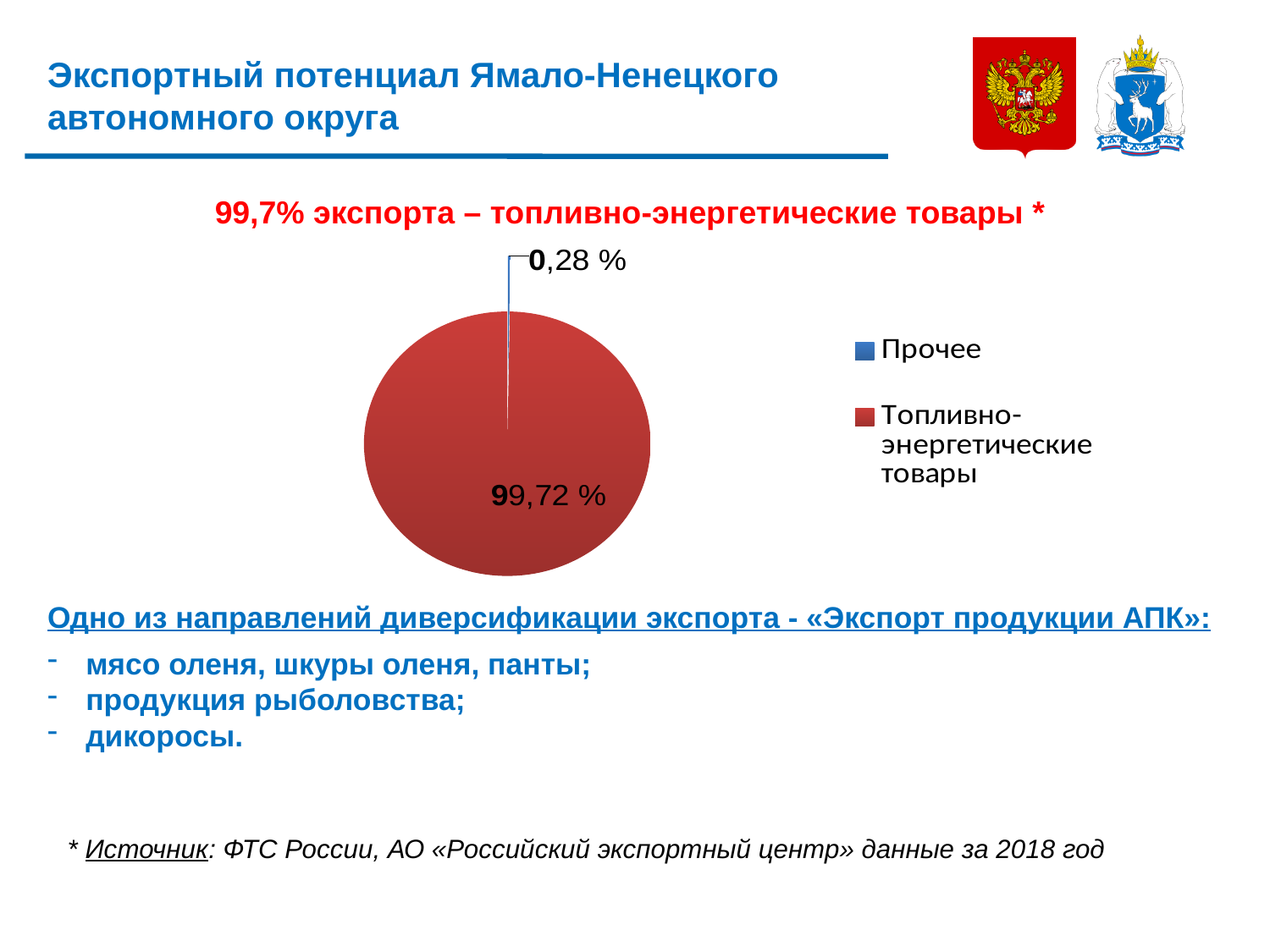
How many slices does the pie chart have? 2 What share of exports do fuel and energy goods (Топливно-энергетические товары) account for in the pie chart? 99,72 % What colour is the 'Прочее' slice in the pie chart legend? blue Which is larger in the pie chart: 'Прочее' or 'Топливно-энергетические товары'? Топливно-энергетические товары Which slice of the pie chart is the smallest? Прочее What colour is the 'Топливно-энергетические товары' slice in the pie chart? red What share of exports does the 'Прочее' slice account for in the pie chart? 0,28 % Which slice of the pie chart is the largest? Топливно-энергетические товары What is the difference in percentage points between the 'Топливно-энергетические товары' slice and the 'Прочее' slice? 99,44 % How many entries does the legend of the pie chart list? 2 What kind of chart is shown on the slide? pie chart